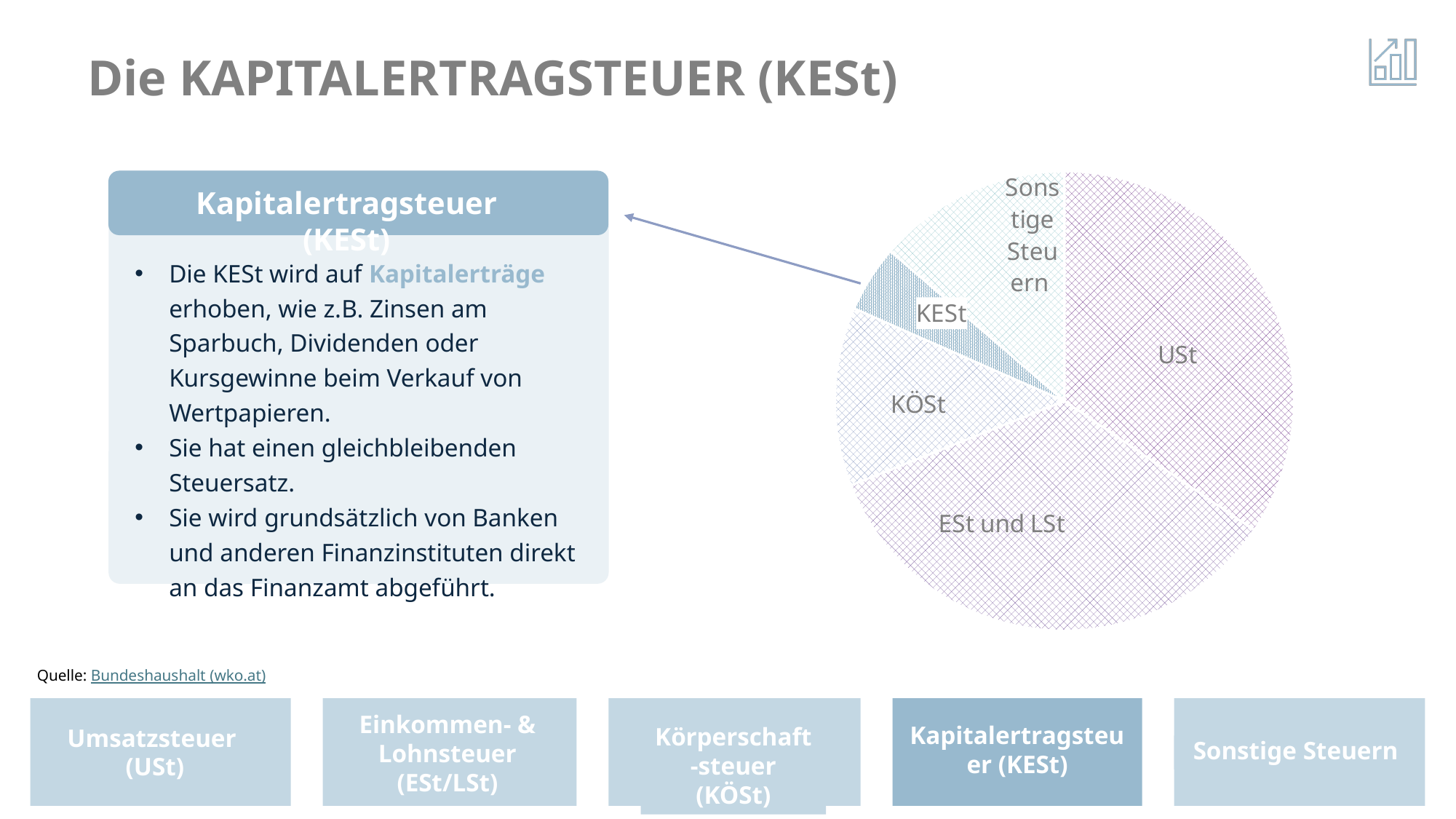
Which slice is larger in the pie chart, ESt und LSt or KESt? ESt und LSt Which slice is larger in the pie chart, KESt or KÖSt? KÖSt Which slice is larger in the pie chart, USt or KESt? USt Which slice of the pie chart does the arrow from the text box point to? KESt Which slice of the pie chart is labelled at the top, next to the USt slice? Sonstige Steuern Which slice of the pie chart is the smallest? KESt How many slices does the pie chart have? 5 What kind of chart is shown on the slide? pie chart